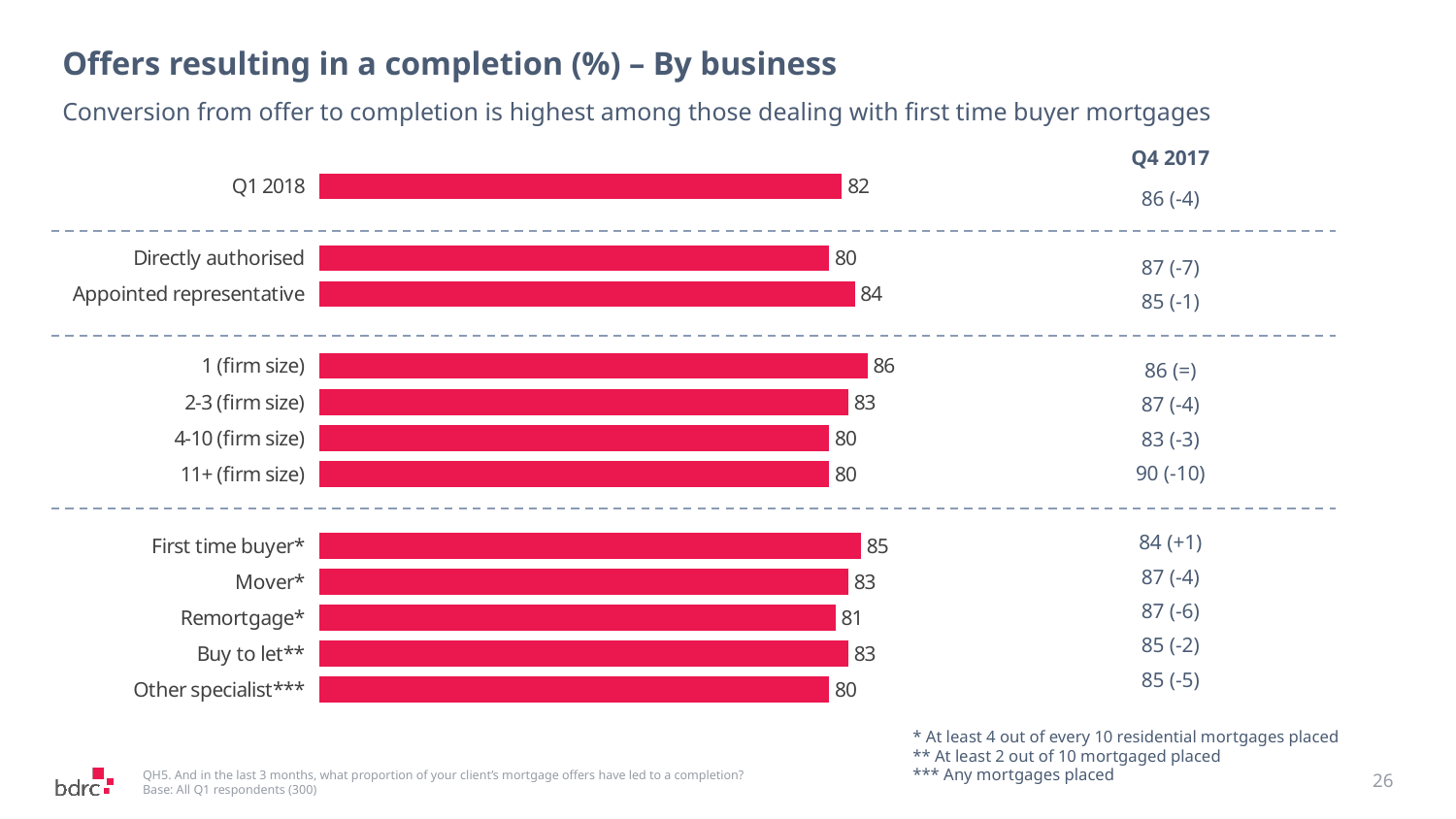
What is the Q1 2018 value for the overall Q1 2018 bar at the top of the chart? 82 What is the Q1 2018 value for Appointed representative? 84 What is the title of the chart on the slide? Offers resulting in a completion (%) – By business Which has a larger Q1 2018 value, First time buyer* or Remortgage*? First time buyer* What is the difference between the Q1 2018 values for Appointed representative and Directly authorised? 4 What Q4 2017 value is shown for 11+ (firm size)? 90 (-10) What is the Q1 2018 value for Remortgage*? 81 How many bars are plotted in the chart? 12 What kind of chart is shown on the slide? bar chart What is the Q1 2018 value for First time buyer*? 85 What is the difference between the Q1 2018 values for 1 (firm size) and 11+ (firm size)? 6 Which category has the highest Q1 2018 value in the chart? 1 (firm size)